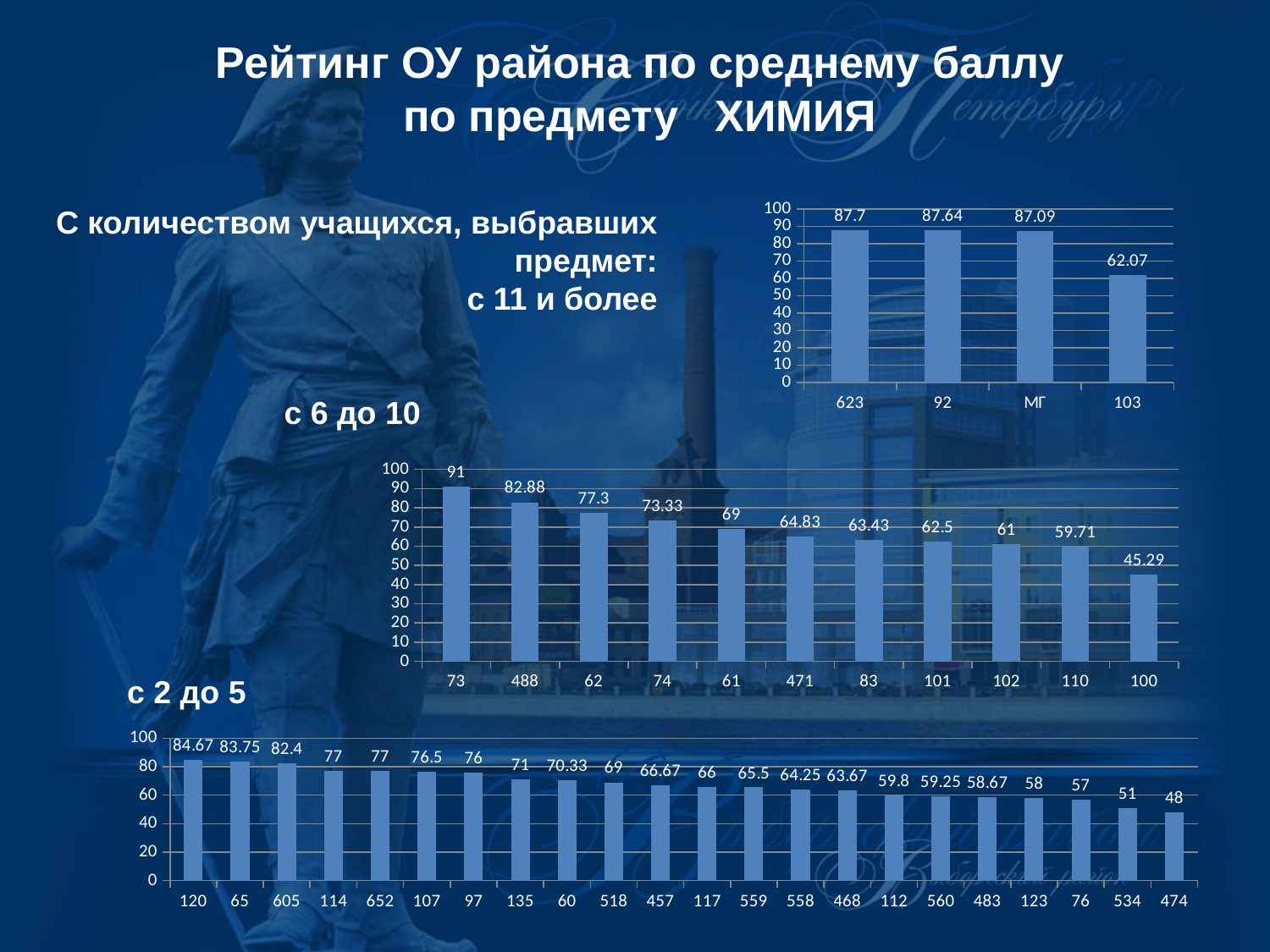
In the middle chart (с 6 до 10), what is the value for category 488? 82.88 In the middle chart (с 6 до 10), do the values rise or fall from left to right? fall What type of chart is the bottom chart (с 2 до 5)? bar chart In the middle chart (с 6 до 10), how many categories are shown on the x axis? 11 In the middle chart (с 6 до 10), what is the difference between the values for 73 and 100? 45.71 In the bottom chart (с 2 до 5), what is the value for category 559? 65.5 In the top-right chart (с 11 и более), what is the value for category 623? 87.7 In the top-right chart (с 11 и более), which category has the lowest value? 103 In the middle chart (с 6 до 10), which category has the highest value? 73 In the bottom chart (с 2 до 5), how many bars are plotted? 22 In the top-right chart (с 11 и более), how many bars are plotted? 4 In the bottom chart (с 2 до 5), which is larger, the value for 120 or the value for 474? 120